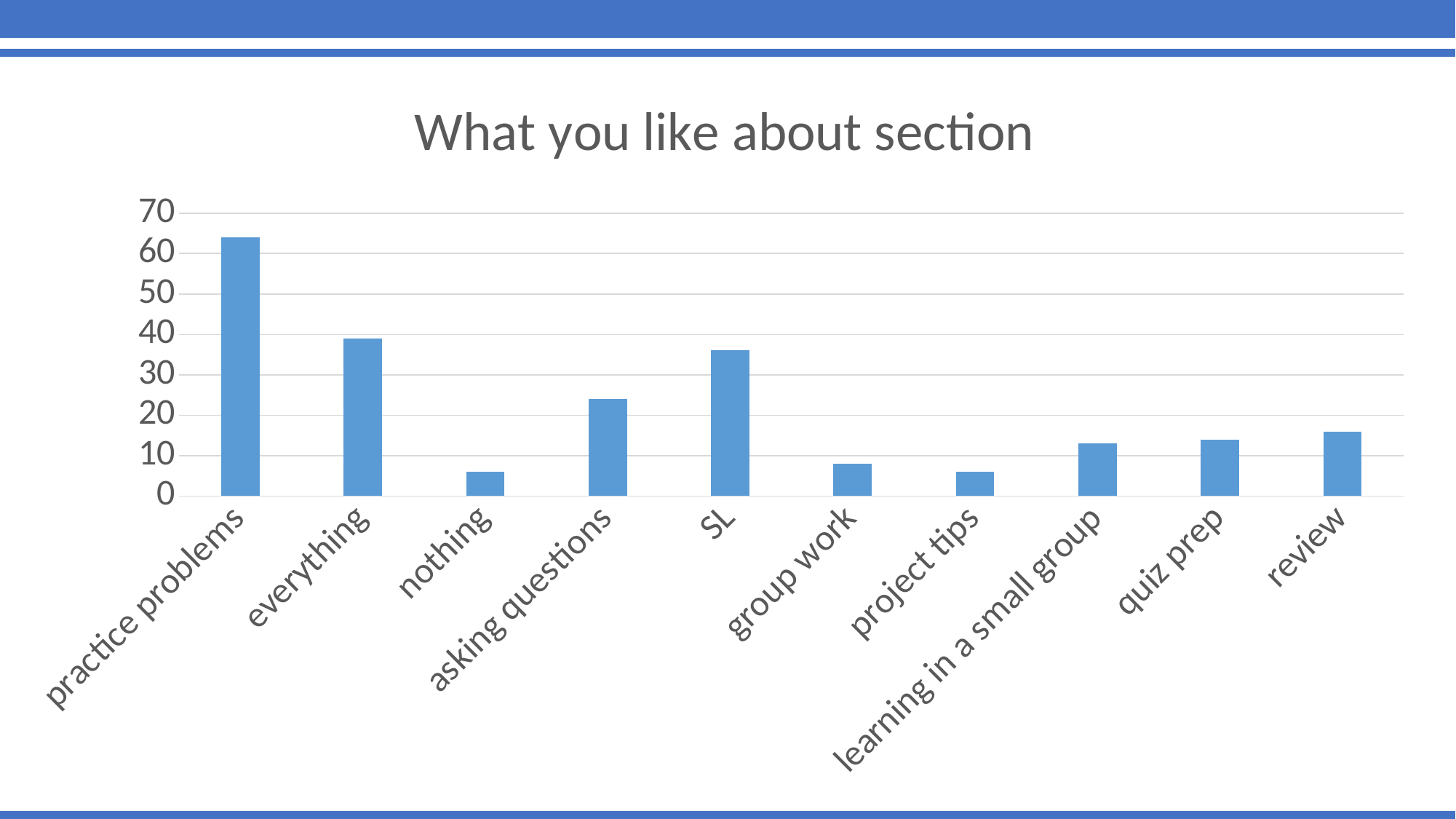
What is the title of the chart? What you like about section Is the value for SL greater or less than 40? less How many categories are shown on the x axis of the chart? 10 Is the value for practice problems greater or less than 60? greater Is the value for everything greater or less than 30? greater Which category has the highest value in the chart? practice problems Which is larger, the value for practice problems or the value for everything? practice problems What kind of chart is shown on the slide? bar chart Which is larger, the value for asking questions or the value for SL? SL